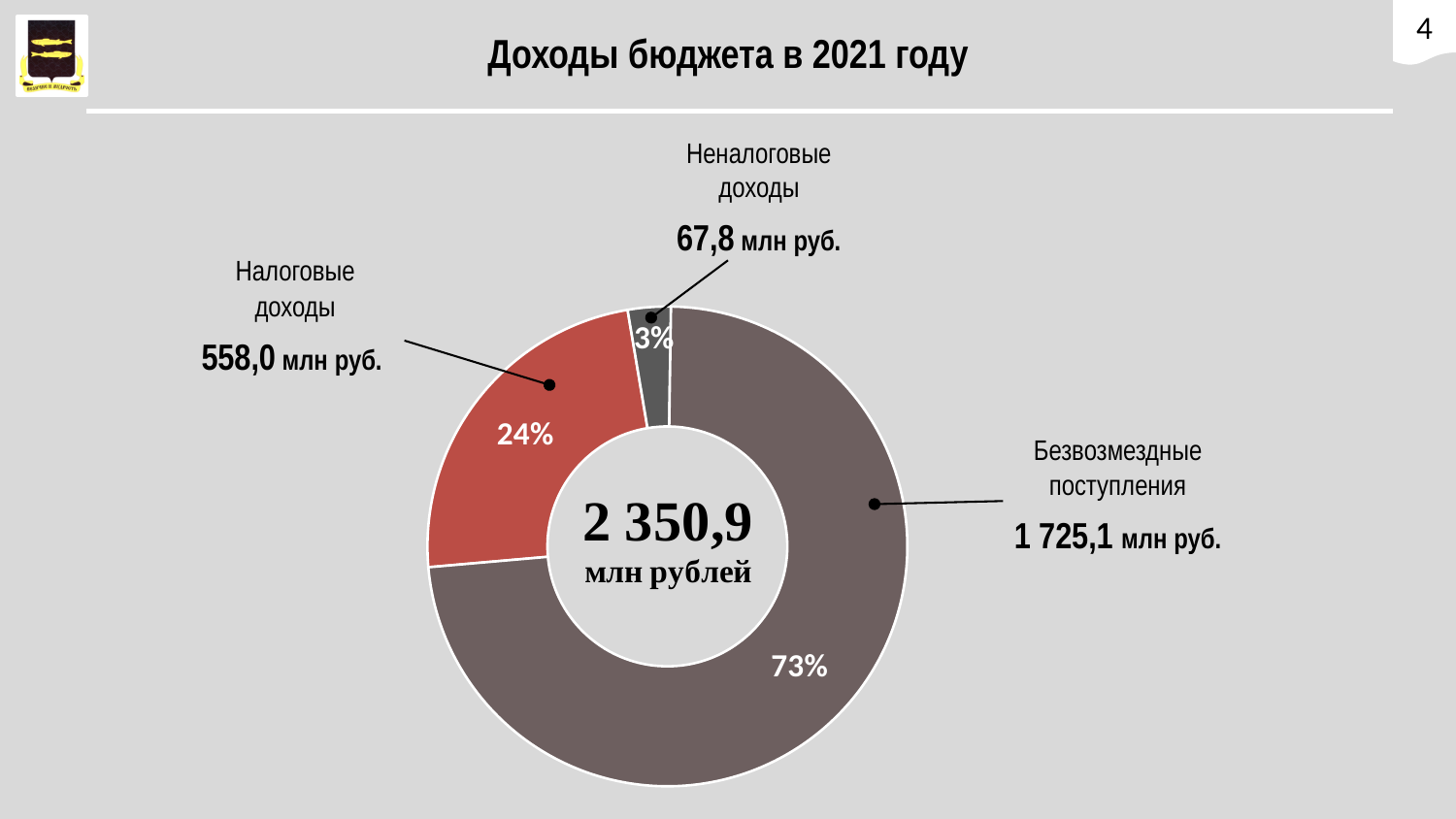
What share of the chart does Налоговые доходы represent? 24% What is the value for Неналоговые доходы? 67,8 млн руб. What total value is shown in the centre of the chart? 2 350,9 млн рублей What is the value for Безвозмездные поступления? 1 725,1 млн руб. Which category has the largest value? Безвозмездные поступления How many categories does the chart show? 3 What share of the chart does Неналоговые доходы represent? 3% What is the title of the chart on the slide? Доходы бюджета в 2021 году What share of the chart does Безвозмездные поступления represent? 73% What kind of chart is shown on the slide? Pie (donut) chart What is the value for Налоговые доходы? 558,0 млн руб. Which category has the smallest value? Неналоговые доходы